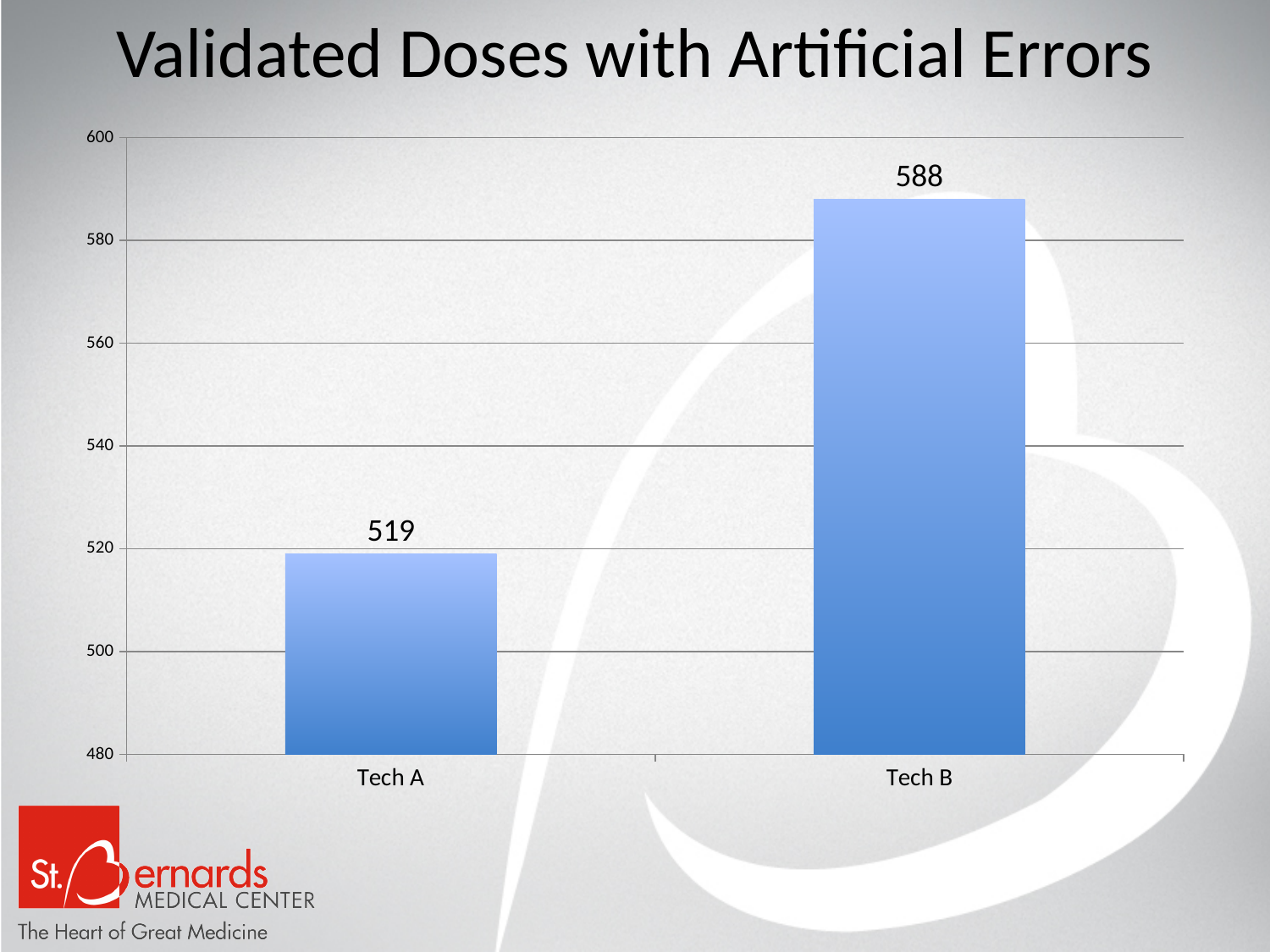
Is the value for Tech B greater or less than 580? greater What is the difference between the values for Tech B and Tech A? 69 What is the lowest value shown on the y axis? 480 What is the title of the chart? Validated Doses with Artificial Errors What is the value for Tech A? 519 Which category has the highest value? Tech B What kind of chart is shown on the slide? bar chart What is the value for Tech B? 588 How many categories are shown on the x axis? 2 Which is larger, the value for Tech A or the value for Tech B? Tech B Is the value for Tech A greater or less than 540? less Which category has the lowest value? Tech A